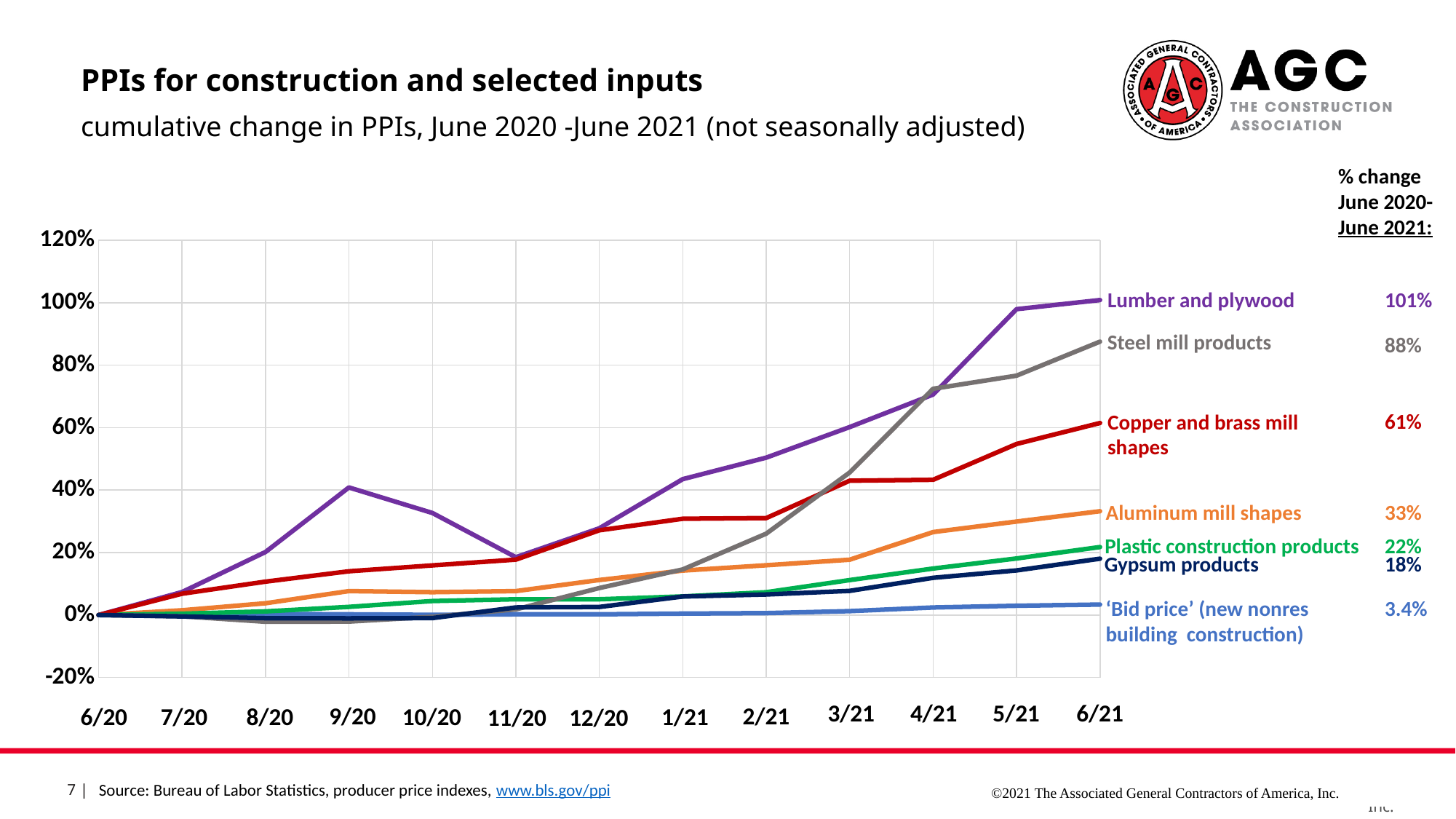
What is the % change from June 2020 to June 2021 for the 'Bid price' (new nonres building construction)? 3.4% What is the difference between the June 2020-June 2021 % change for Lumber and plywood and for Steel mill products? 13% What is the % change from June 2020 to June 2021 for Aluminum mill shapes? 33% What is the % change from June 2020 to June 2021 for Steel mill products? 88% What kind of chart is shown on the slide? line chart Which series has the lowest % change from June 2020 to June 2021? 'Bid price' (new nonres building construction) Which series has the highest % change from June 2020 to June 2021? Lumber and plywood Is the value for Lumber and plywood at 9/20 greater or less than 20%? greater What is the % change from June 2020 to June 2021 for Lumber and plywood? 101% Which has a larger % change from June 2020 to June 2021, Copper and brass mill shapes or Aluminum mill shapes? Copper and brass mill shapes How many series are plotted on the chart? 7 How many months are shown along the x axis? 13